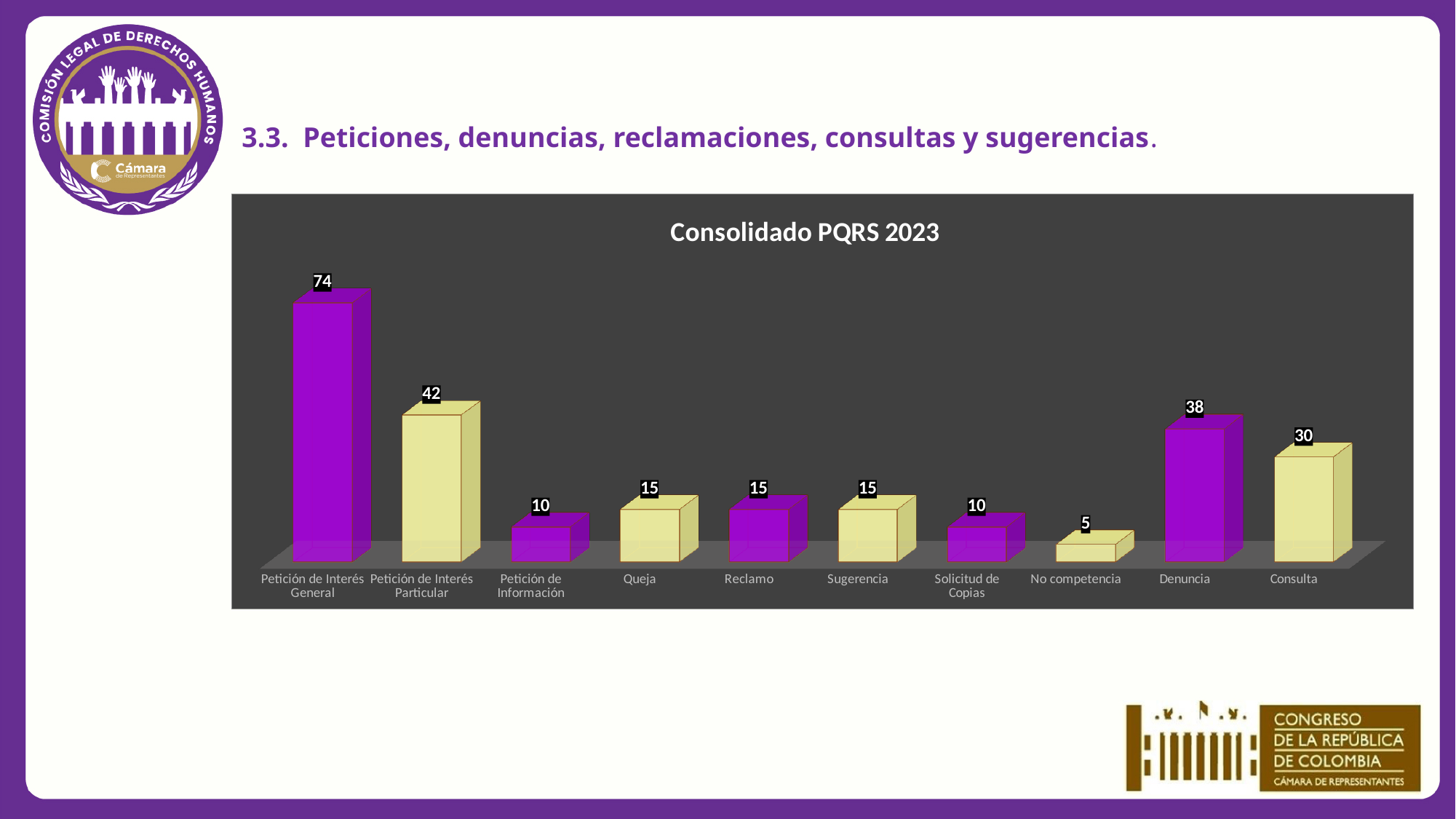
Which is larger, Petición de Interés Particular or Denuncia? Petición de Interés Particular Which category has the highest value? Petición de Interés General What is the difference between Denuncia and Consulta? 8 Which category has the lowest value? No competencia What is the title of the chart? Consolidado PQRS 2023 What is the value for Consulta? 30 How many categories are shown in the chart? 10 What is the difference between Petición de Interés General and Petición de Interés Particular? 32 What is the value for Petición de Interés General? 74 What is the value for No competencia? 5 What kind of chart is shown? bar chart What is the value for Denuncia? 38